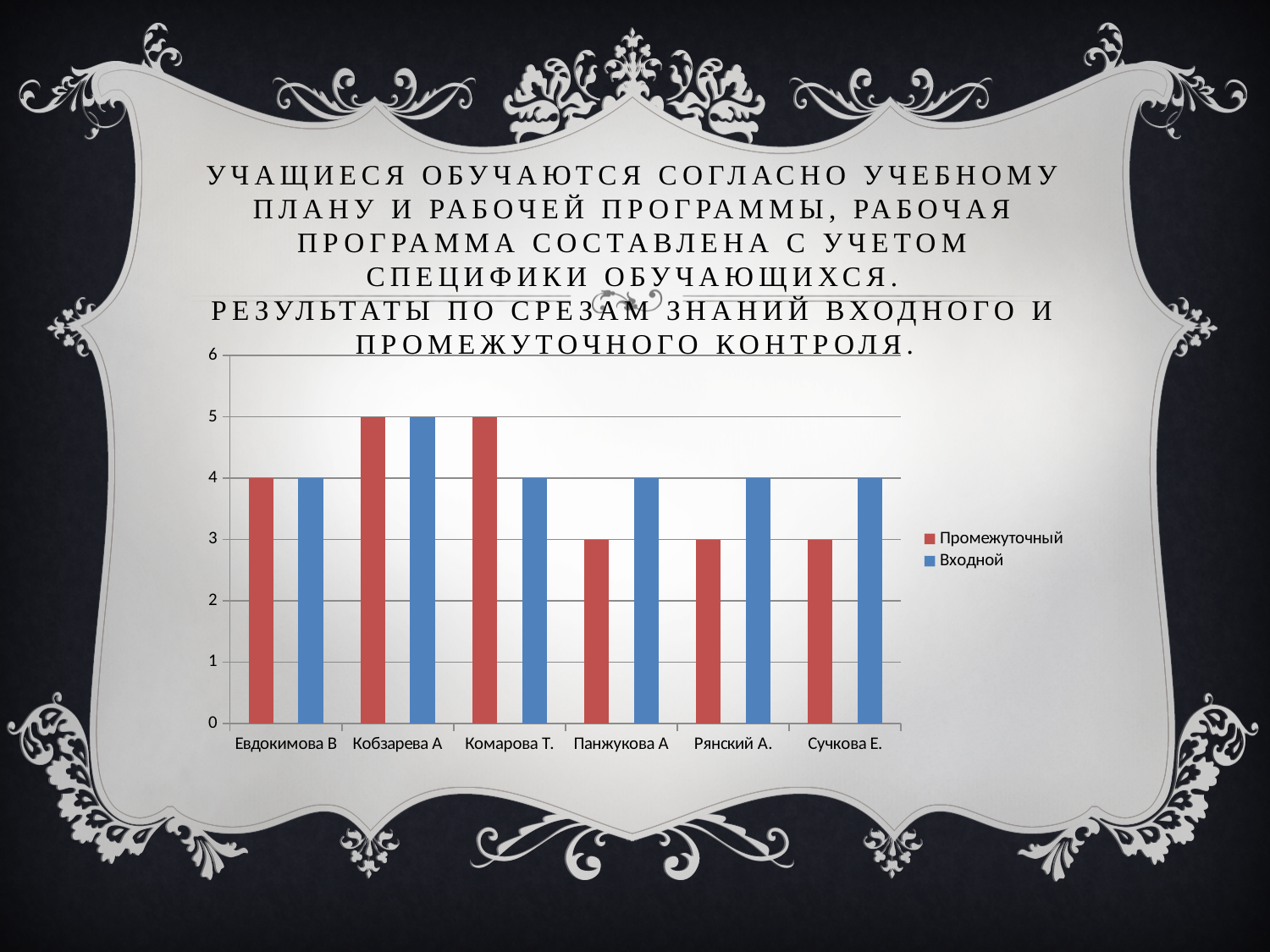
Is the Промежуточный value for Панжукова А greater or less than 4? less What kind of chart is shown on the slide? bar chart Which series is shown in red in the legend? Промежуточный What is the Входной value for Кобзарева А? 5 How many series does the legend list? 2 What is the difference between the Входной and Промежуточный values for Рянский А.? 1 What is the Входной value for Панжукова А? 4 For Комарова Т., which is larger: the Промежуточный value or the Входной value? Промежуточный What is the Промежуточный value for Комарова Т.? 5 How many students (categories) are shown on the x axis? 6 What is the Промежуточный value for Сучкова Е.? 3